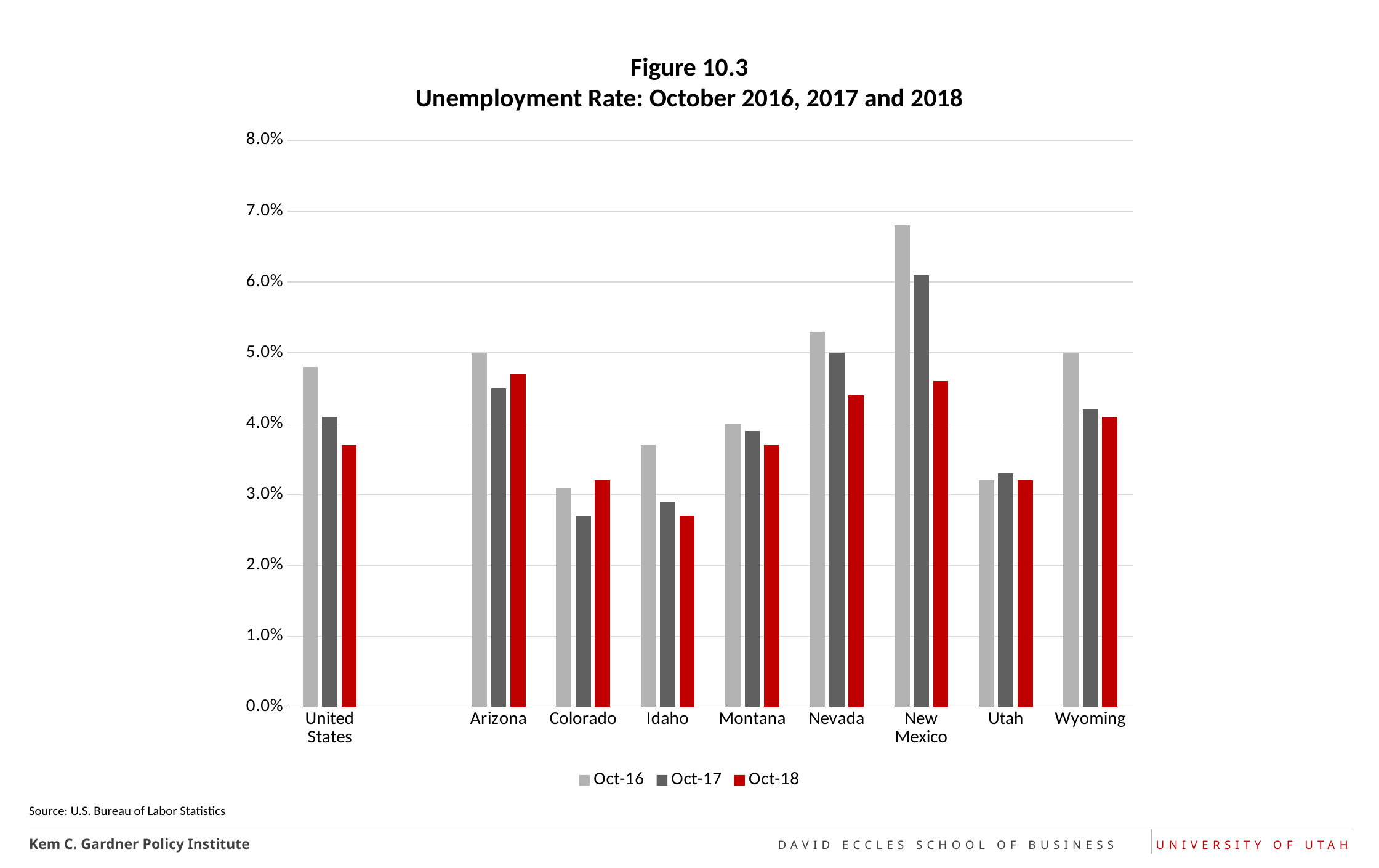
How many categories are shown on the x axis? 9 Is the Oct-16 value for New Mexico greater or less than 6.0%? greater What is the Oct-16 unemployment rate for Arizona? 5.0% Which series is shown in red in the legend? Oct-18 Which category has the lowest Oct-18 unemployment rate? Idaho Which category has the highest Oct-16 unemployment rate? New Mexico Is the Oct-16 value for Nevada greater or less than 5.0%? greater What kind of chart is shown on the slide? bar chart Which is larger, the Oct-18 value for Arizona or the Oct-18 value for Nevada? Arizona Is the Oct-17 value for Colorado greater or less than 3.0%? less Do the United States values rise or fall from Oct-16 to Oct-18? fall How many series does the legend list? 3